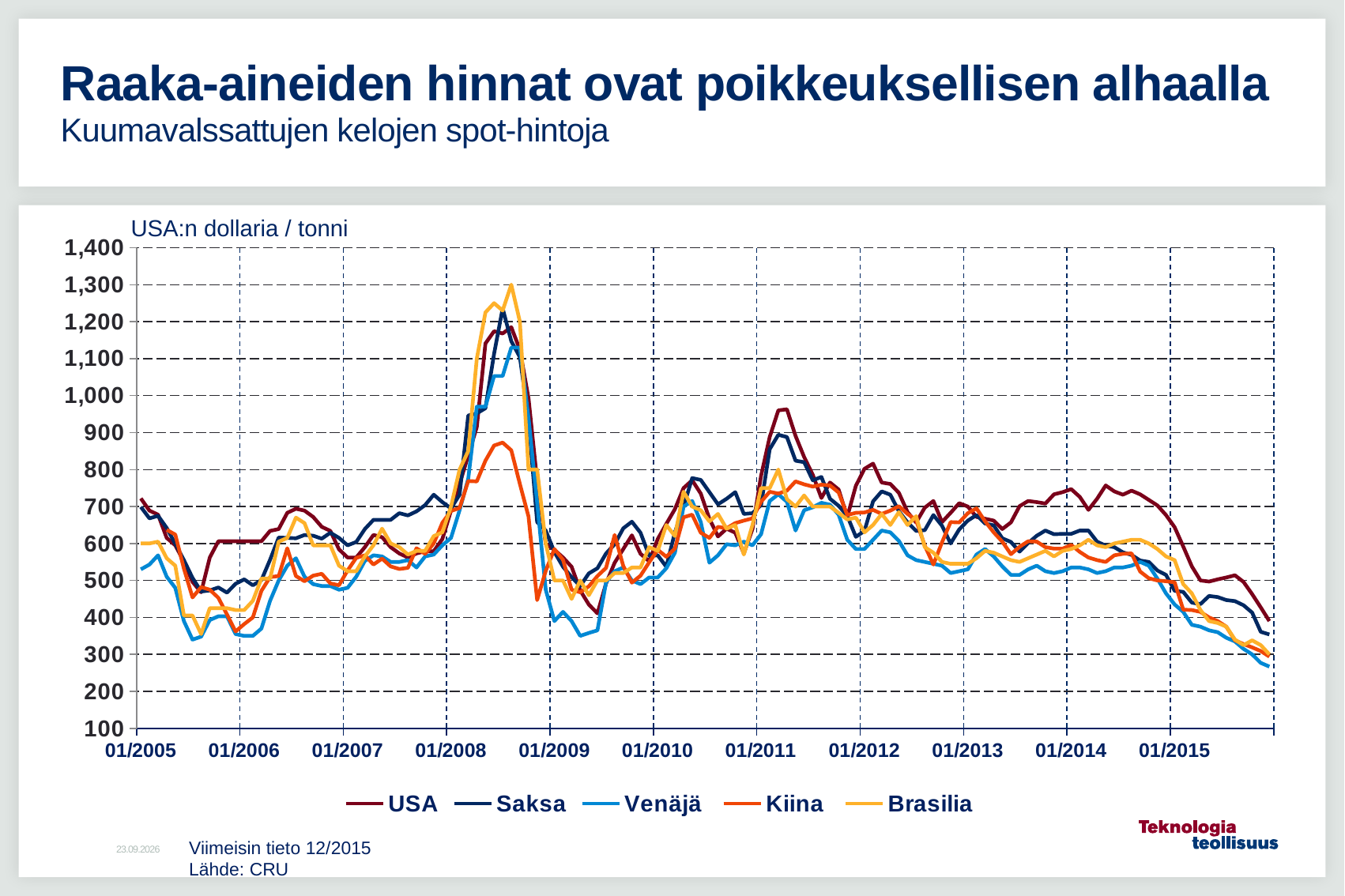
How many series does the legend list? 5 Does the Venäjä series rise or fall from 01/2014 to the end of the series? fall At the end of the series (12/2015), which series is higher, USA or Venäjä? USA At the 2008 peak, which series is higher, Brasilia or Kiina? Brasilia How many year labels are shown on the x axis? 11 Which series reaches the highest value anywhere on the chart? Brasilia Is the value for Venäjä at the end of the series (12/2015) greater or less than 300? less Is the peak value for Brasilia in 2008 greater or less than 1,200? greater Is the value for Venäjä at 01/2006 greater or less than 400? less What kind of chart is shown on the slide? line chart What unit is stated above the chart's y axis? USA:n dollaria / tonni